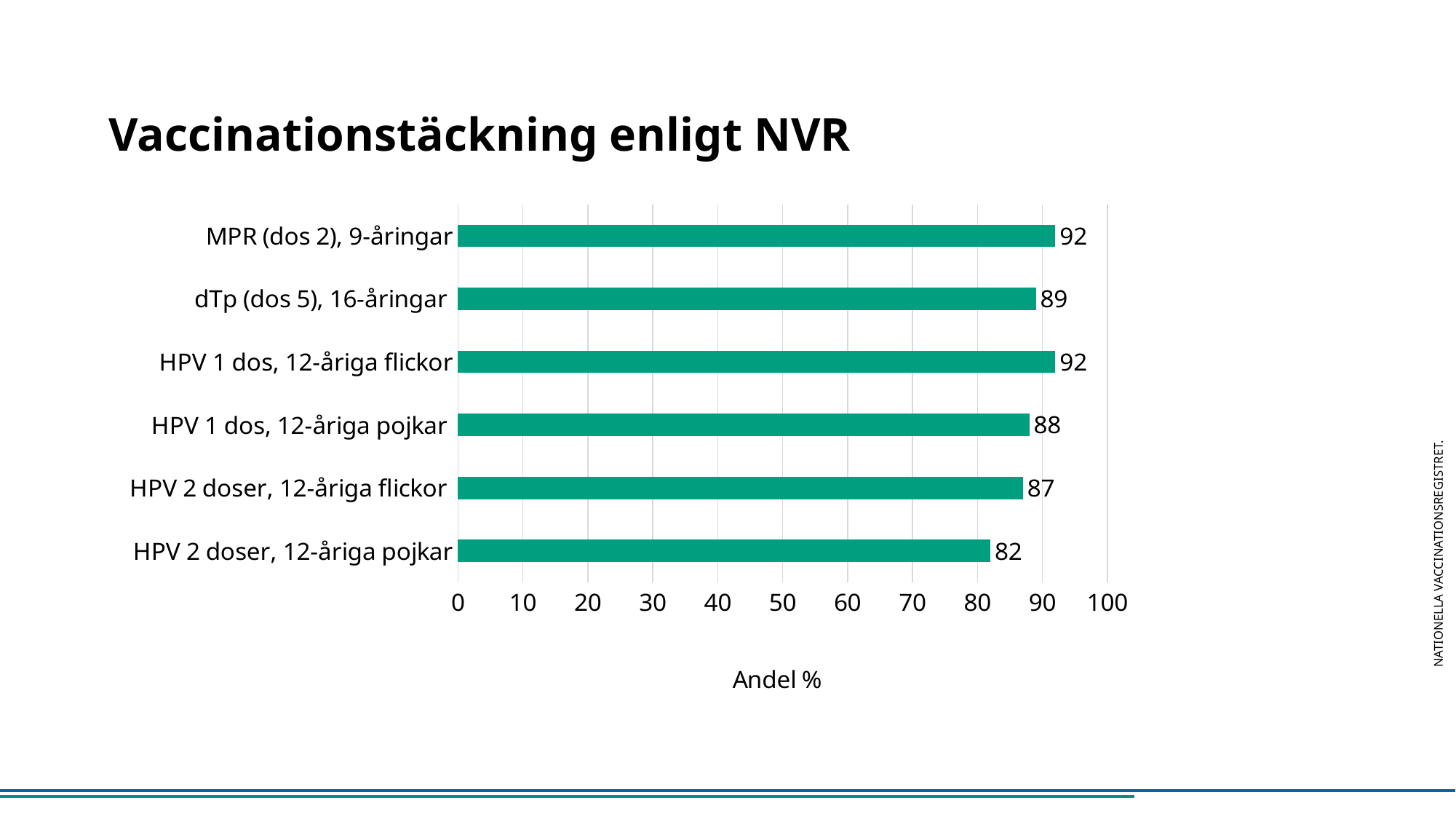
What is the value for dTp (dos 5), 16-åringar? 89 What is the difference between the values for HPV 2 doser, 12-åriga flickor and HPV 2 doser, 12-åriga pojkar? 5 What is the value for MPR (dos 2), 9-åringar? 92 Is the value for HPV 2 doser, 12-åriga pojkar greater or less than 90? less What is the label of the horizontal axis? Andel % What is the value for HPV 1 dos, 12-åriga pojkar? 88 How many categories are shown in the chart? 6 What is the value for HPV 2 doser, 12-åriga pojkar? 82 Which category has the lowest value? HPV 2 doser, 12-åriga pojkar What is the title of the chart? Vaccinationstäckning enligt NVR Which is larger, the value for dTp (dos 5), 16-åringar or the value for HPV 1 dos, 12-åriga pojkar? dTp (dos 5), 16-åringar What kind of chart is shown on the slide? bar chart